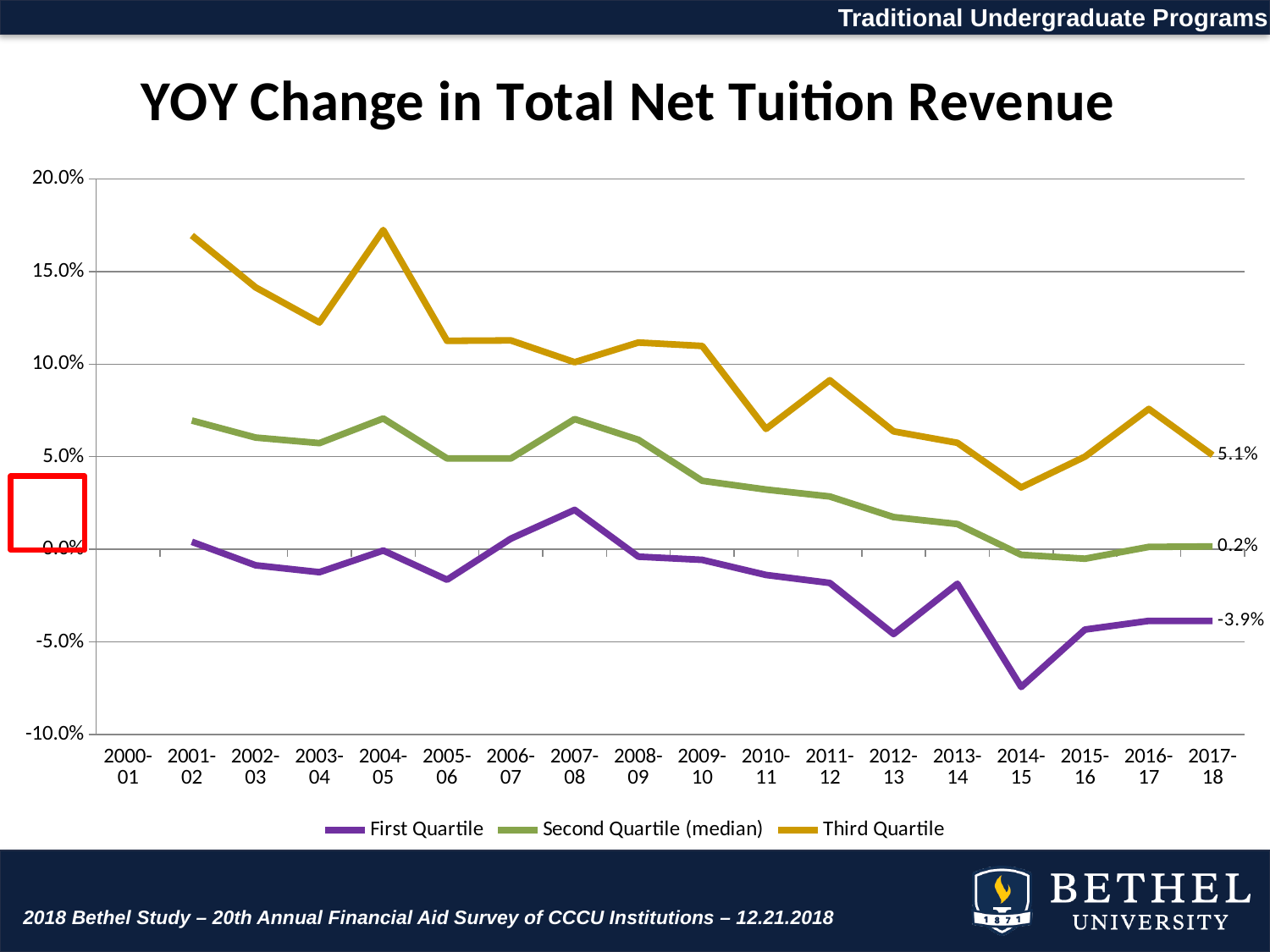
How many series does the legend list? 3 Is the First Quartile value for 2014-15 greater or less than -5.0%? less Which series has the highest value in 2017-18? Third Quartile What is the Second Quartile (median) value for 2017-18? 0.2% What is the Third Quartile value for 2017-18? 5.1% What is the difference between the Third Quartile and First Quartile values in 2017-18? 9.0 percentage points What type of chart is shown on the slide? Line chart Is the Third Quartile value for 2004-05 greater or less than 15.0%? greater Which series has the lowest value in 2017-18? First Quartile Does the Third Quartile line generally rise or fall from 2001-02 to 2017-18? Fall What is the First Quartile value for 2017-18? -3.9% What is the title of the chart? YOY Change in Total Net Tuition Revenue